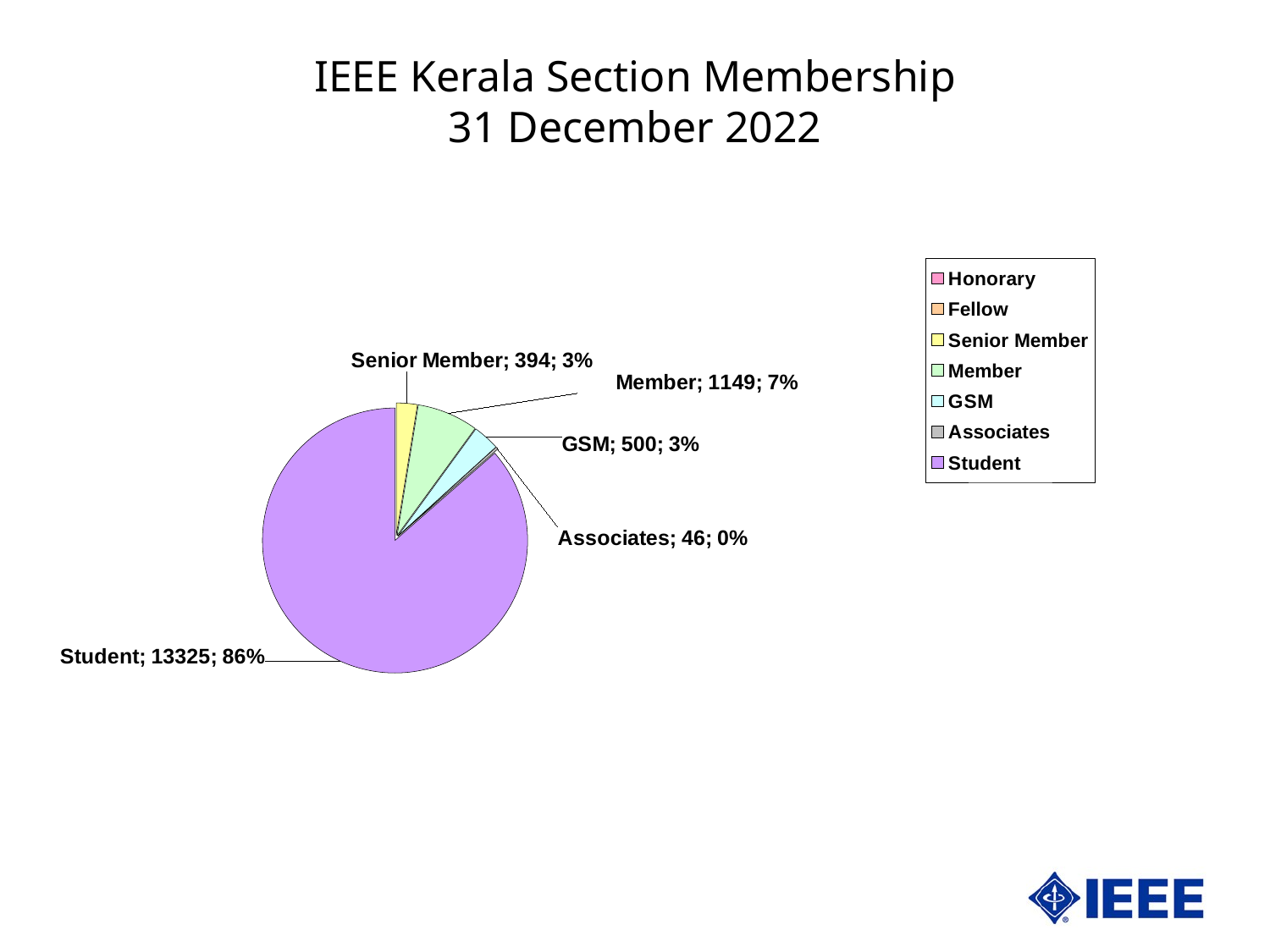
What is the value shown for Associates? 46 Which category has the largest slice of the pie? Student What is the value shown for GSM? 500 How many categories are listed in the legend? 7 What is the value shown for Senior Member? 394 How many members does the Student slice represent? 13325 What kind of chart is shown on the slide? pie chart What share of the pie does the Member slice represent? 7% What is the difference between the Member value and the GSM value? 649 What is the value shown for Member? 1149 Which is larger, the GSM value or the Senior Member value? GSM What share of the pie does the Student slice represent? 86%